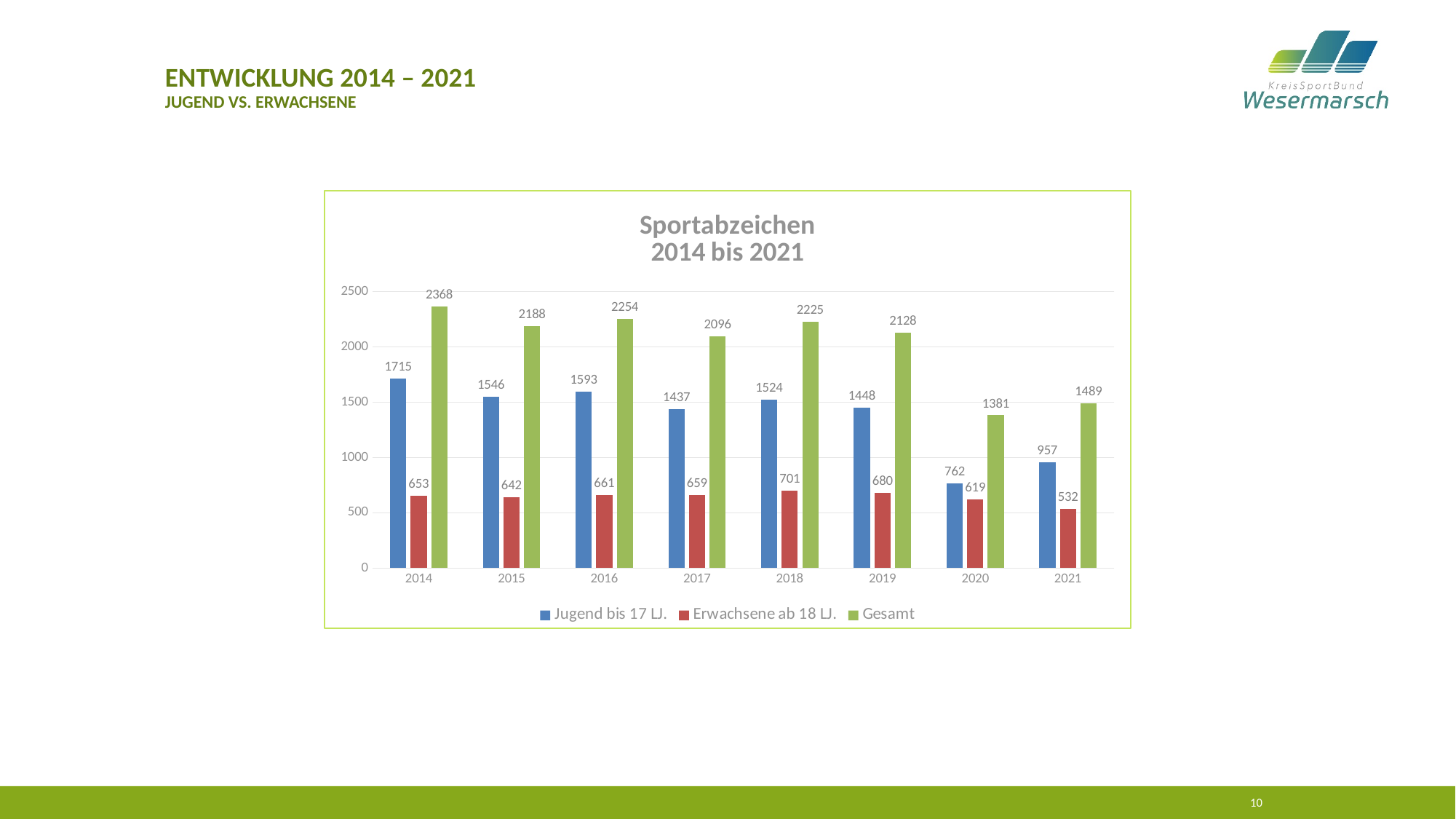
What is the value for Jugend bis 17 LJ. in 2014? 1715 What is the difference between the Gesamt values for 2014 and 2021? 879 In which year is the Gesamt value highest? 2014 What is the title of the chart? Sportabzeichen 2014 bis 2021 Does the Gesamt value rise or fall from 2019 to 2020? Fall What kind of chart is shown on the slide? Bar chart How many years are shown on the x axis? 8 What is the Gesamt value for 2021? 1489 In which year is the Jugend bis 17 LJ. value lowest? 2020 How many series does the legend list? 3 What is the value for Erwachsene ab 18 LJ. in 2018? 701 Which is larger, the Erwachsene ab 18 LJ. value in 2019 or in 2020? 2019